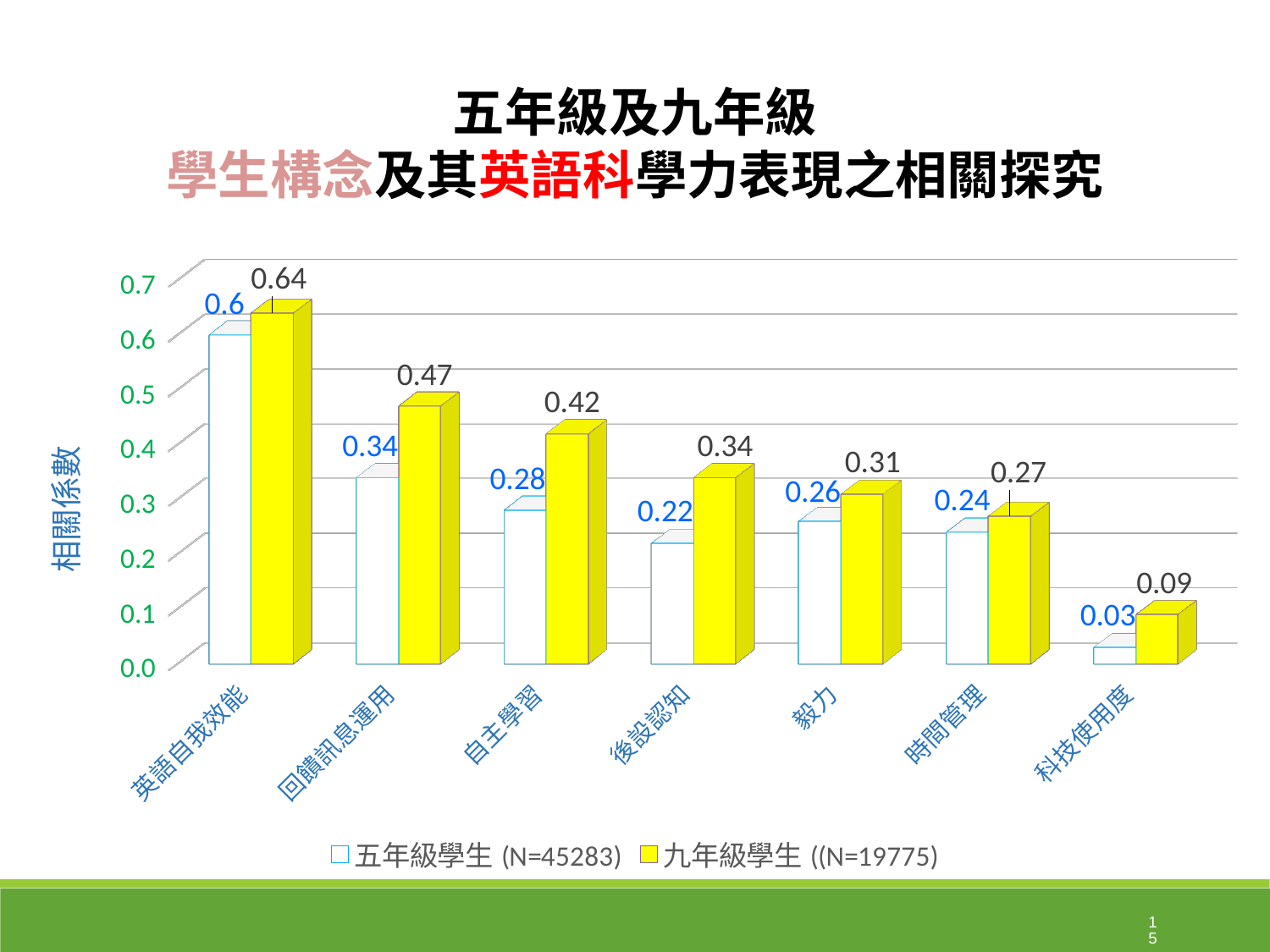
Which category has the highest value for 九年級學生? 英語自我效能 What is the label of the vertical axis? 相關係數 What kind of chart is shown on the slide? bar chart How many categories are shown on the x axis? 7 Which category has the lowest value for 五年級學生? 科技使用度 What is the value for 九年級學生 in the 科技使用度 category? 0.09 What is the difference between the 九年級學生 and 五年級學生 values for 自主學習? 0.14 What is the value for 五年級學生 in the 英語自我效能 category? 0.6 What is the value for 九年級學生 in the 回饋訊息運用 category? 0.47 How many series does the legend list? 2 What is the value for 五年級學生 in the 後設認知 category? 0.22 Which is larger for 毅力: the value for 五年級學生 or for 九年級學生? 九年級學生